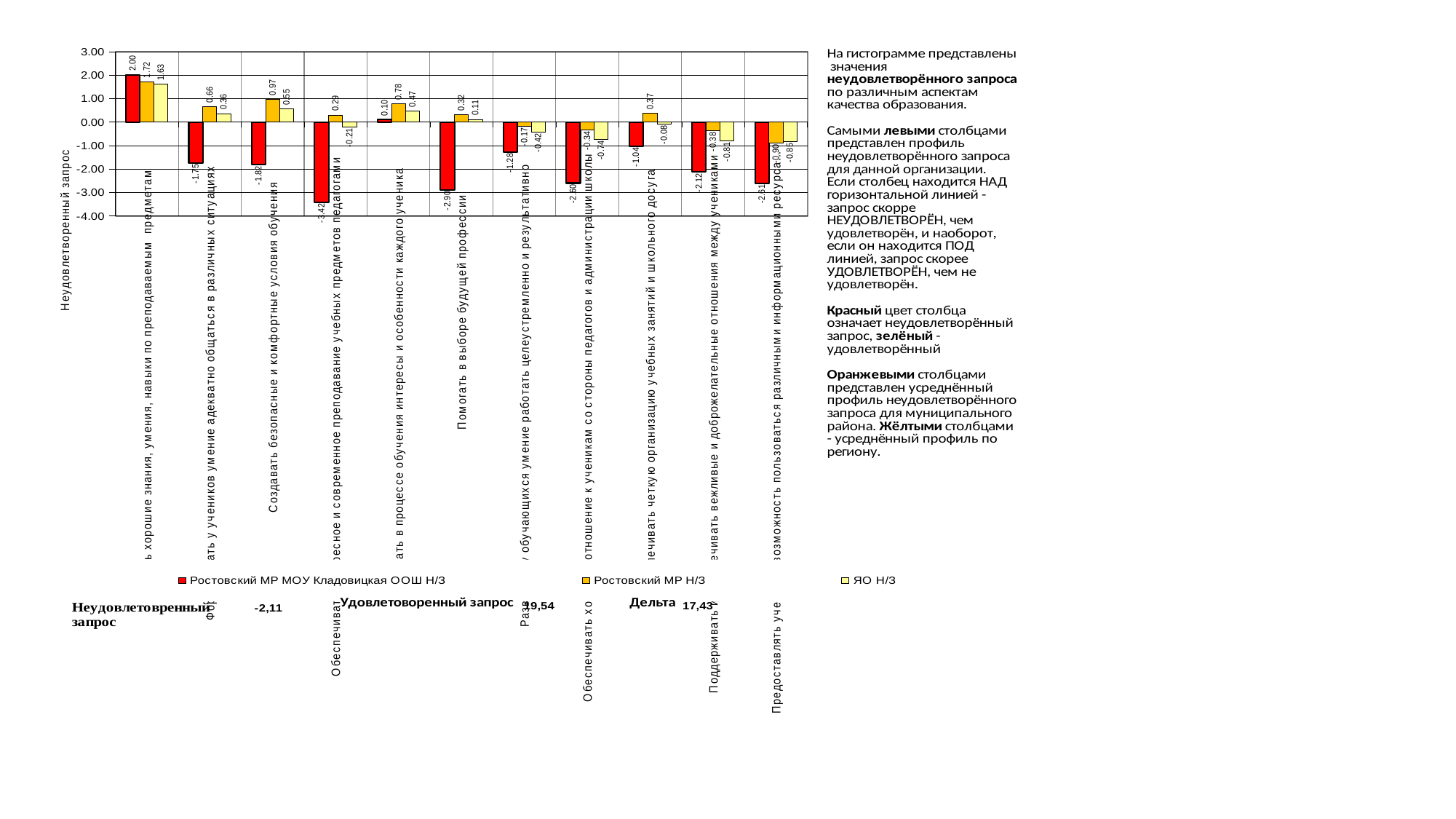
What is the highest value plotted for the 'Ростовский МР МОУ Кладовицкая ООШ Н/З' series? 2.00 For 'Помогать в выборе будущей профессии', what is the difference between the 'Ростовский МР Н/З' value and the 'ЯО Н/З' value? 0.21 What is the value of the 'Ростовский МР МОУ Кладовицкая ООШ Н/З' series for 'Создавать безопасные и комфортные условия обучения'? -1.82 What is the lowest value plotted for the 'Ростовский МР МОУ Кладовицкая ООШ Н/З' series? -3.42 Is the 'Ростовский МР МОУ Кладовицкая ООШ Н/З' value for 'Помогать в выборе будущей профессии' greater or less than -2.00? less What kind of chart is shown on the slide? Bar chart For 'Создавать безопасные и комфортные условия обучения', which series has the larger value: 'Ростовский МР Н/З' or 'ЯО Н/З'? Ростовский МР Н/З What is the title of the vertical axis of the chart? Неудовлетворенный запрос What is the value of the 'ЯО Н/З' series for 'Создавать безопасные и комфортные условия обучения'? 0.55 What is the value of the 'Ростовский МР Н/З' series for 'Помогать в выборе будущей профессии'? 0.32 How many categories are plotted along the x axis of the chart? 11 How many series does the chart legend list? 3